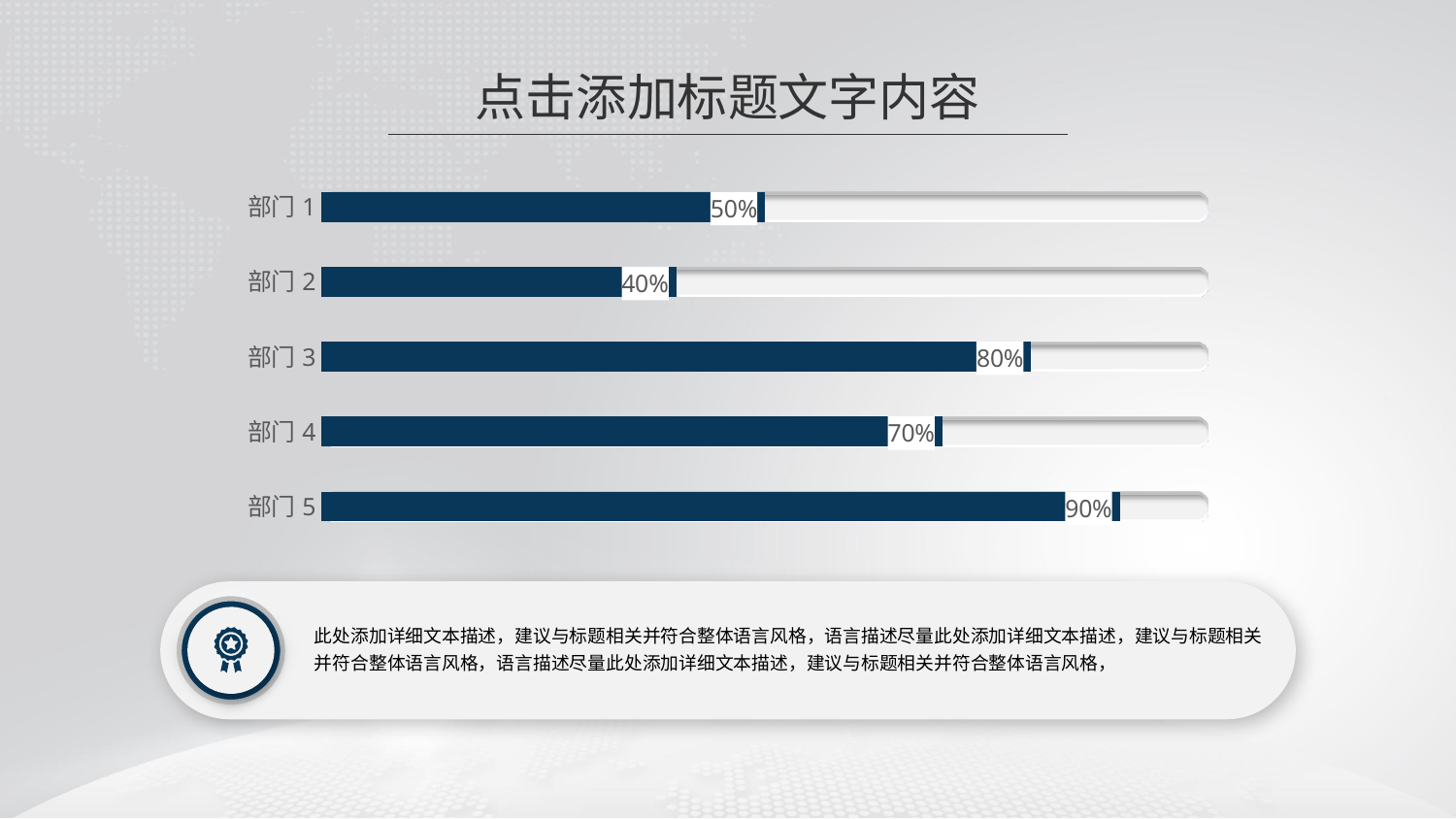
What is the difference between the values for 部门 5 and 部门 2? 50% What is the value for 部门 4? 70% What is the value for 部门 5? 90% Which category has the lowest value? 部门 2 What is the value for 部门 3? 80% How many categories are shown in the chart? 5 Which category has the highest value? 部门 5 What is the value for 部门 1? 50% Which is larger, the value for 部门 1 or the value for 部门 4? 部门 4 What kind of chart is shown on the slide? bar chart What colour are the bars representing the values in the chart? dark blue What is the difference between the values for 部门 3 and 部门 4? 10%